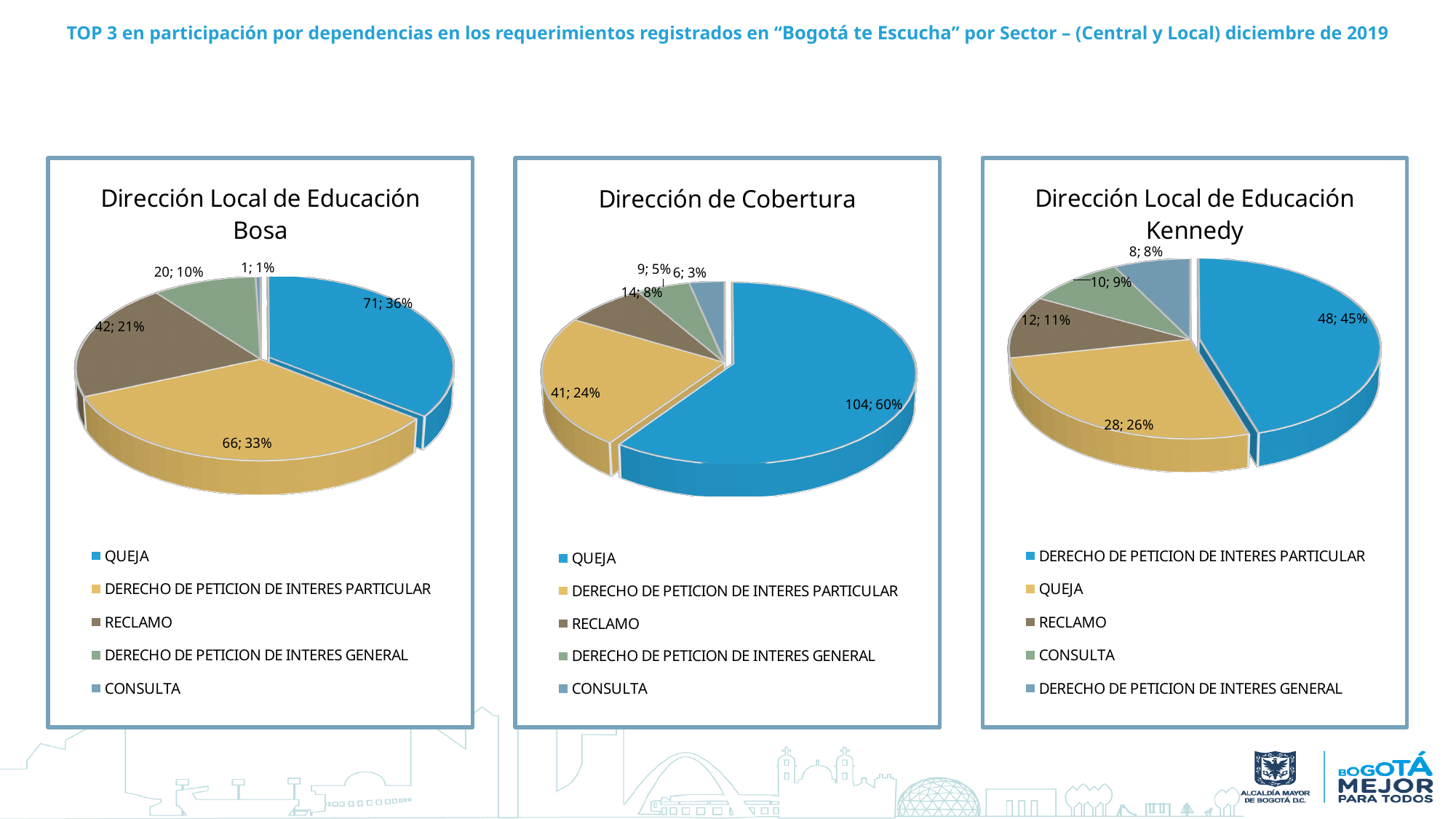
In the 'Dirección Local de Educación Bosa' chart, which category has the smallest slice? CONSULTA In the 'Dirección Local de Educación Bosa' chart, what is the difference in count between QUEJA and DERECHO DE PETICION DE INTERES PARTICULAR? 5 In the 'Dirección de Cobertura' chart, what share of the pie does RECLAMO represent? 8% In the 'Dirección de Cobertura' chart, what value is shown for QUEJA? 104; 60% In the 'Dirección Local de Educación Kennedy' chart, what value is shown for DERECHO DE PETICION DE INTERES PARTICULAR? 48; 45% In the 'Dirección de Cobertura' chart, which category has the largest slice? QUEJA How many categories does the legend of the 'Dirección Local de Educación Kennedy' chart list? 5 In the 'Dirección Local de Educación Bosa' chart, what value is shown for QUEJA? 71; 36% In the 'Dirección Local de Educación Kennedy' chart, which category has the smallest slice? DERECHO DE PETICION DE INTERES GENERAL What type of chart is used for 'Dirección de Cobertura'? Pie chart In the 'Dirección Local de Educación Kennedy' chart, what is the difference in count between QUEJA and RECLAMO? 16 In the 'Dirección de Cobertura' chart, which is larger: DERECHO DE PETICION DE INTERES GENERAL or CONSULTA? DERECHO DE PETICION DE INTERES GENERAL